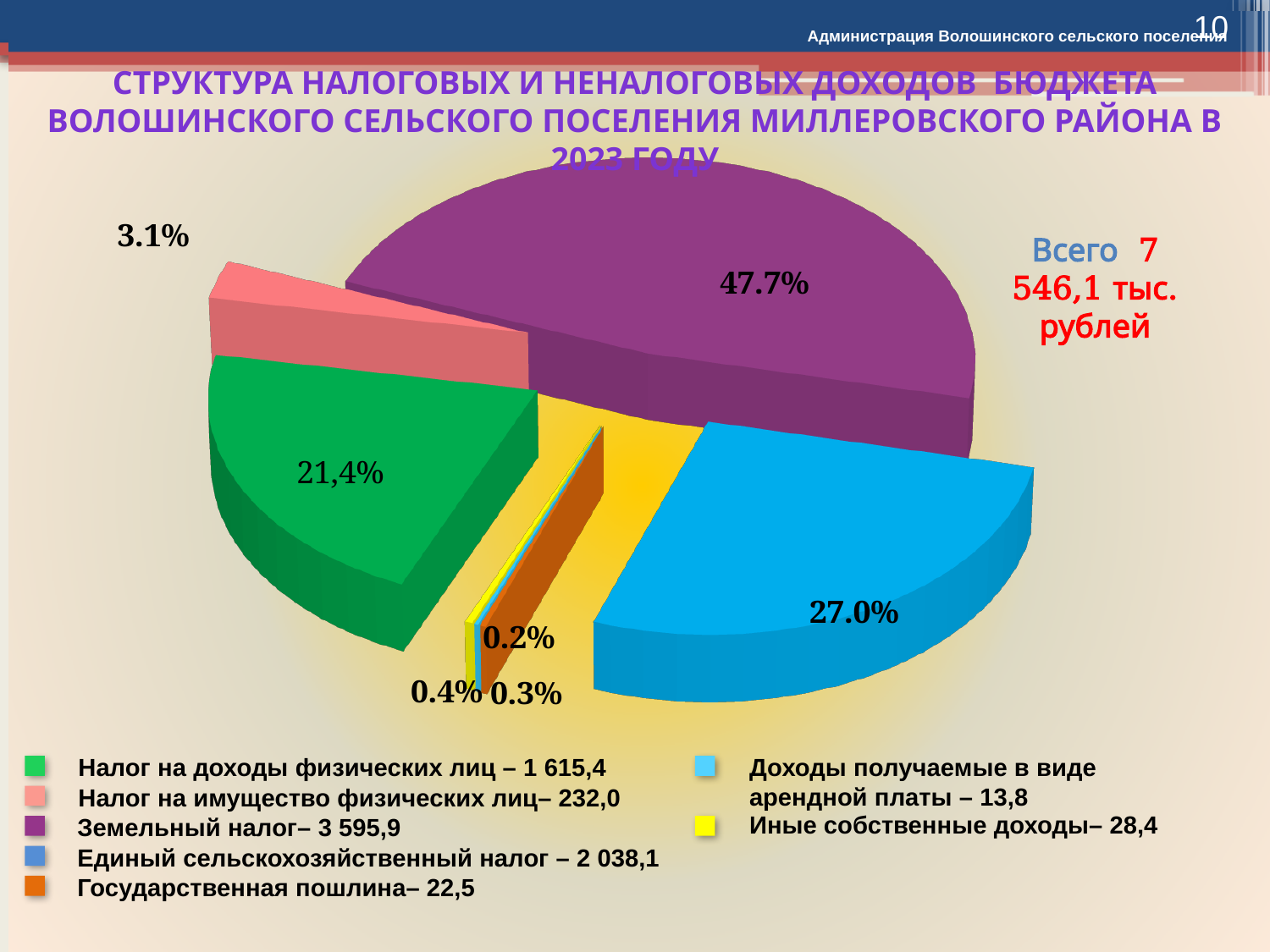
Which is larger: the share for Налог на доходы физических лиц or for Налог на имущество физических лиц? Налог на доходы физических лиц What total (Всего) is stated on the slide? 7 546,1 тыс. рублей What percentage share is shown for the largest slice (Земельный налог)? 47.7% Which category has the largest share of the pie? Земельный налог What percentage share is shown for Налог на доходы физических лиц? 21,4% What percentage share is shown for Единый сельскохозяйственный налог? 27.0% By how many percentage points does the share of Земельный налог (47.7%) exceed that of Единый сельскохозяйственный налог (27.0%)? 20.7 How many categories does the legend list? 7 What value does the legend give for Государственная пошлина? 22,5 What kind of chart is shown on the slide? Pie chart What value does the legend give for Земельный налог? 3 595,9